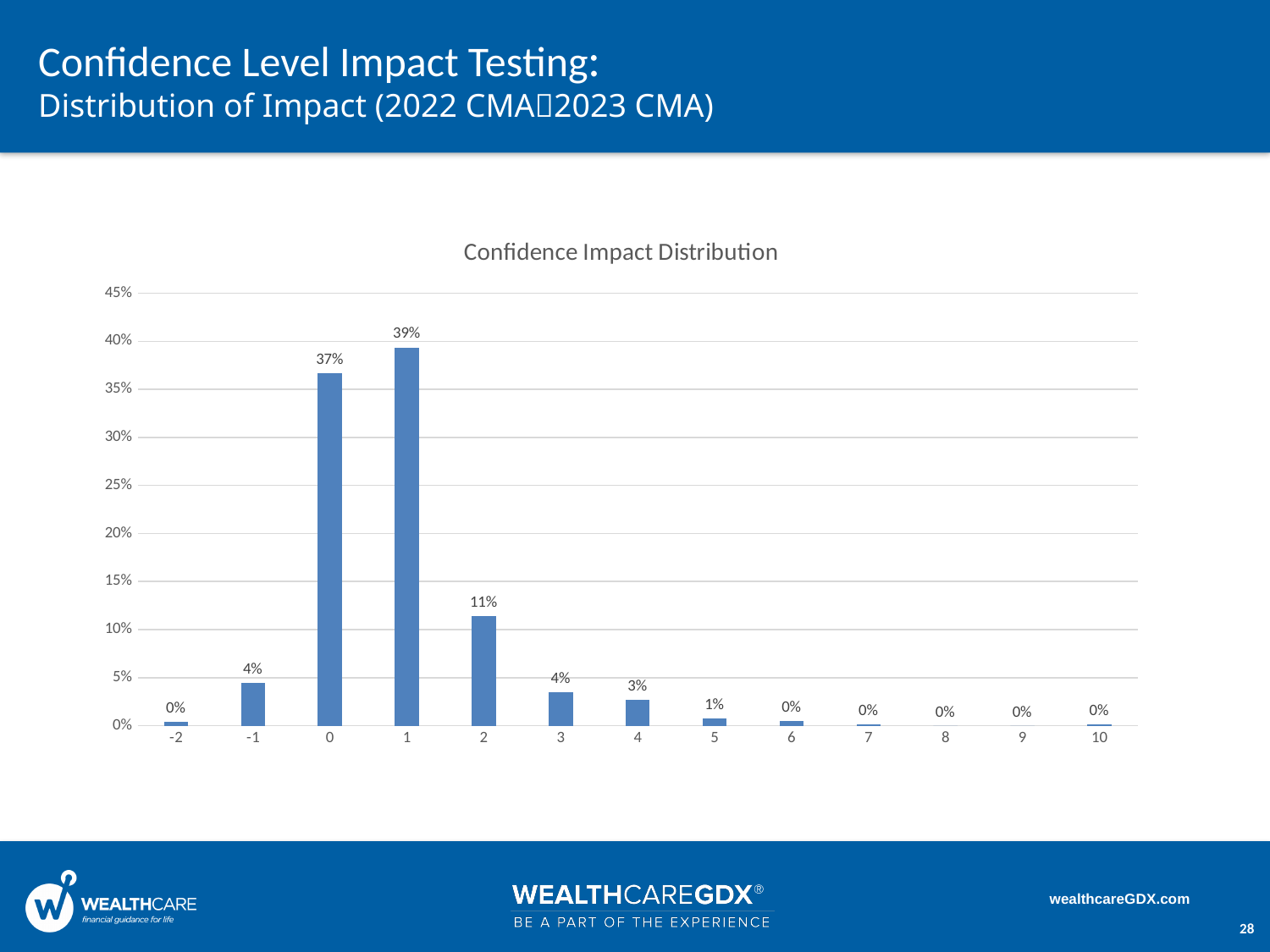
What is the value for category 0 in the Confidence Impact Distribution chart? 37% Which is larger in the Confidence Impact Distribution chart, the value for category 3 or the value for category 4? 3 How many categories are shown on the x axis of the Confidence Impact Distribution chart? 13 What is the value for category 4 in the Confidence Impact Distribution chart? 3% Which category has the highest value in the Confidence Impact Distribution chart? 1 What is the value for category 1 in the Confidence Impact Distribution chart? 39% What is the title of the chart on the slide? Confidence Impact Distribution What kind of chart is the Confidence Impact Distribution chart? Bar chart What is the value for category 2 in the Confidence Impact Distribution chart? 11% What is the difference between the values for categories 1 and 0 in the Confidence Impact Distribution chart? 2% Is the value for category 0 greater or less than 35% in the Confidence Impact Distribution chart? greater What is the difference between the values for categories 2 and 3 in the Confidence Impact Distribution chart? 7%